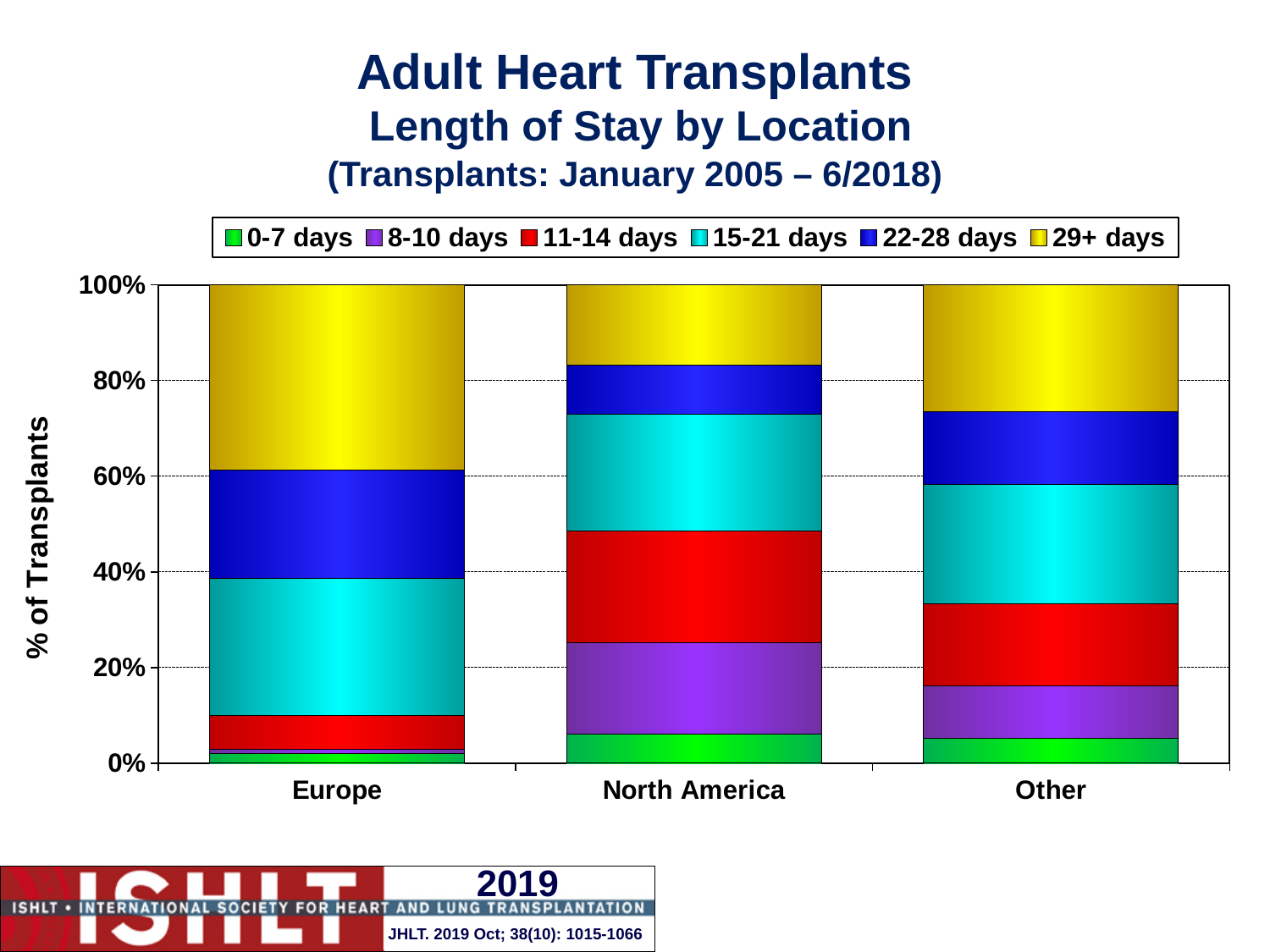
Is the share of 0-7 days transplants in North America greater or less than 20%? less How many locations are shown on the x axis? 3 Which location has the largest share of transplants with a length of stay of 29+ days? Europe Which location has the largest share of transplants with a length of stay of 8-10 days? North America Which location has the smallest share of transplants with a length of stay of 0-7 days? Europe How many length-of-stay categories does the legend list? 6 Is the share of 11-14 days transplants larger in North America or in Europe? North America What is the total of the stacked bar for North America? 100% What is the label on the y axis of the chart? % of Transplants What kind of chart is shown on the slide? Stacked bar chart Is the share of 22-28 days transplants larger in Europe or in North America? Europe Is the share of 29+ days transplants in Europe greater or less than 20%? greater